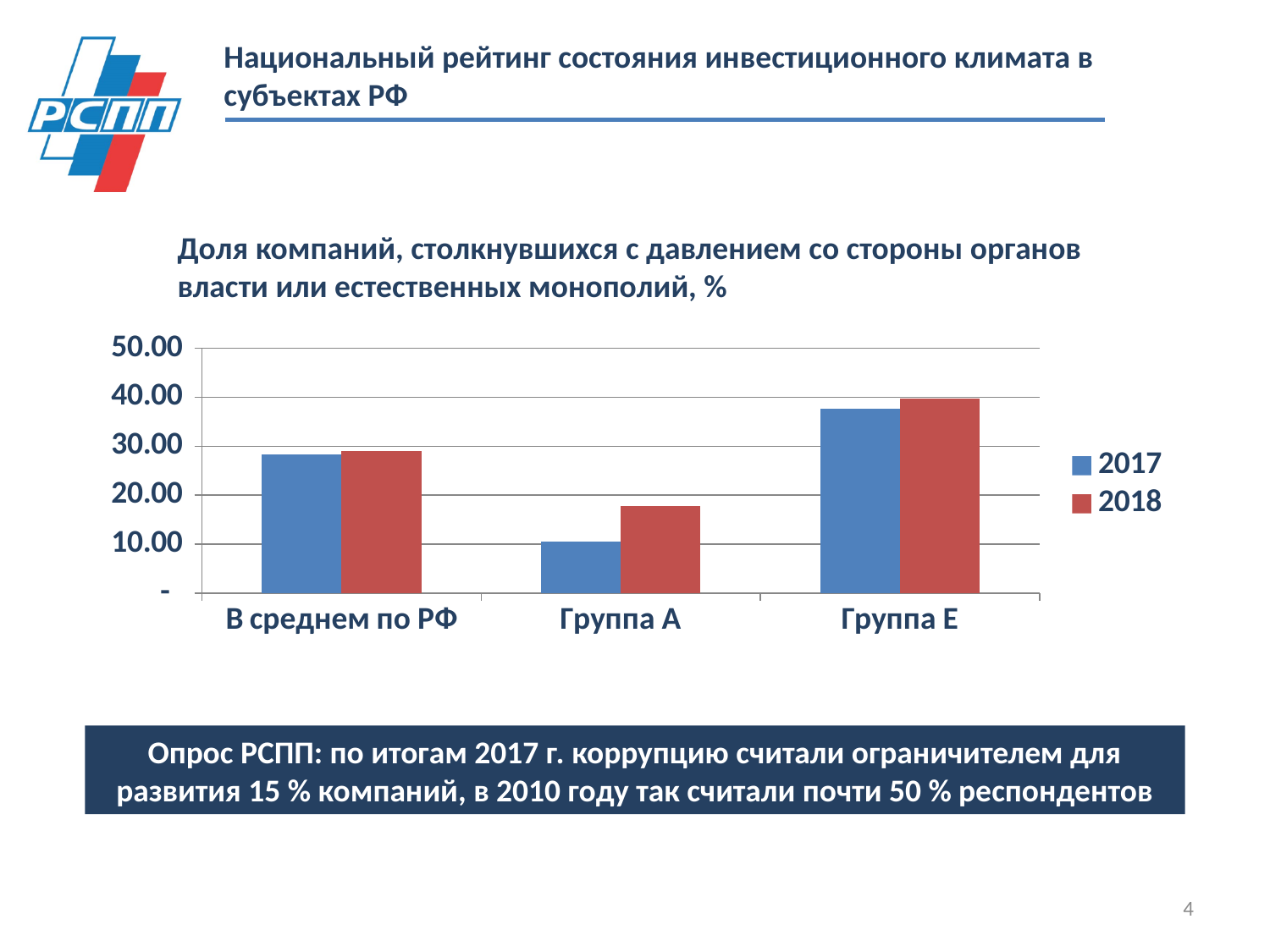
How many series does the chart legend list? 2 What colour are the bars for the 2018 series? red Which category has the highest value for 2018? Группа Е How many categories are shown on the x axis of the chart? 3 Is the 2018 value for Группа Е greater or less than 30.00? greater What kind of chart is shown on the slide? bar chart Is the 2017 value for Группа А greater or less than 20.00? less Which years are listed in the chart legend? 2017 and 2018 For Группа А, which is larger: the 2017 value or the 2018 value? 2018 For 2017, which is larger: the value for Группа Е or the value for Группа А? Группа Е Is the 2017 value for В среднем по РФ greater or less than 40.00? less Which category has the lowest value for 2017? Группа А